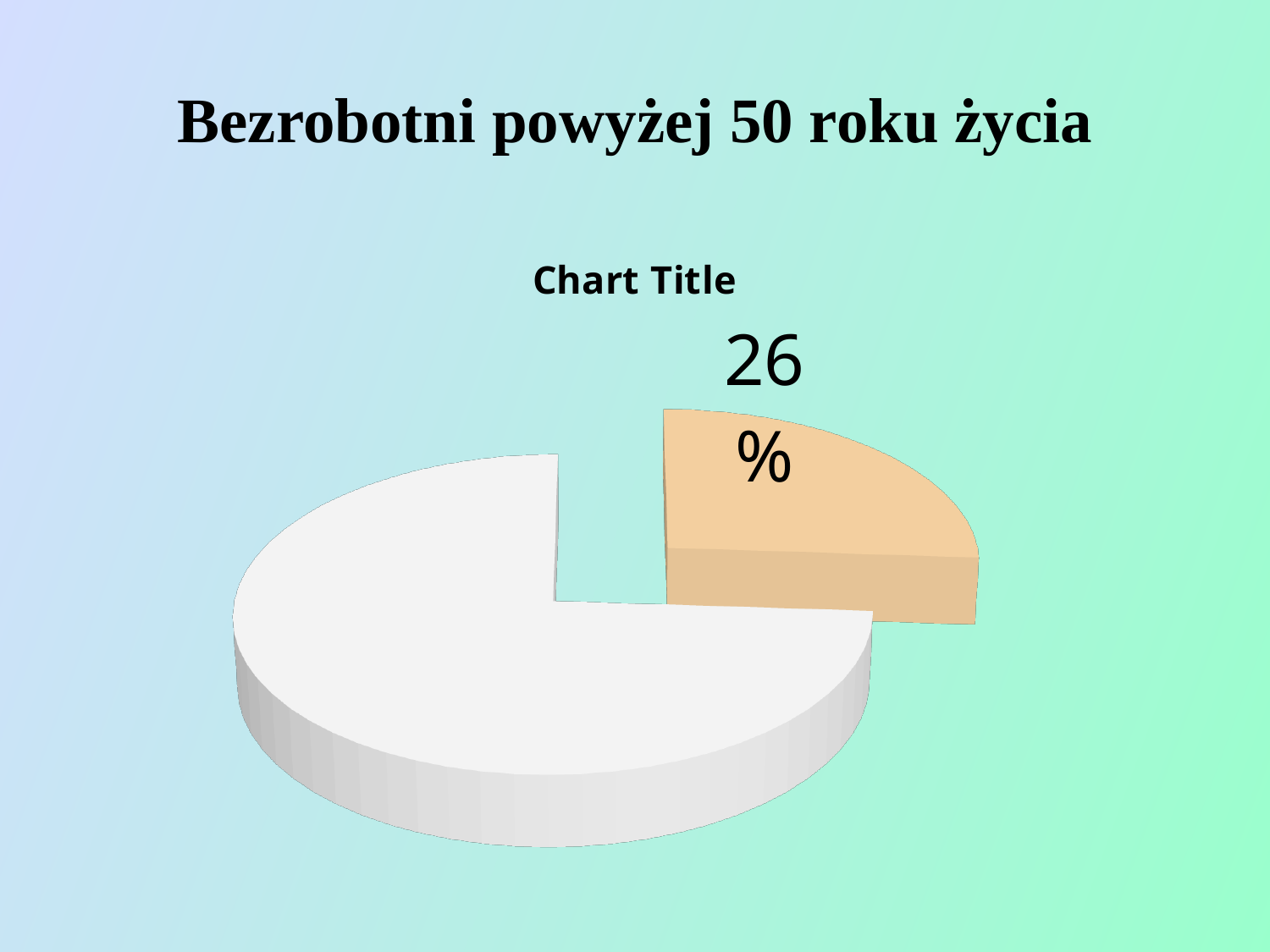
Which slice of the pie is the smallest? the orange slice (26%) What is the title of the slide? Bezrobotni powyżej 50 roku życia What share of the pie does the orange slice represent? 26% What is the title printed above the pie chart? Chart Title How many slices does the pie chart have? 2 What percentage is printed on the orange (exploded) slice of the pie chart? 26% Is the orange slice's share greater or less than 50%? less Which slice of the pie is larger, the white one or the orange one? the white one What kind of chart is shown on the slide? pie chart